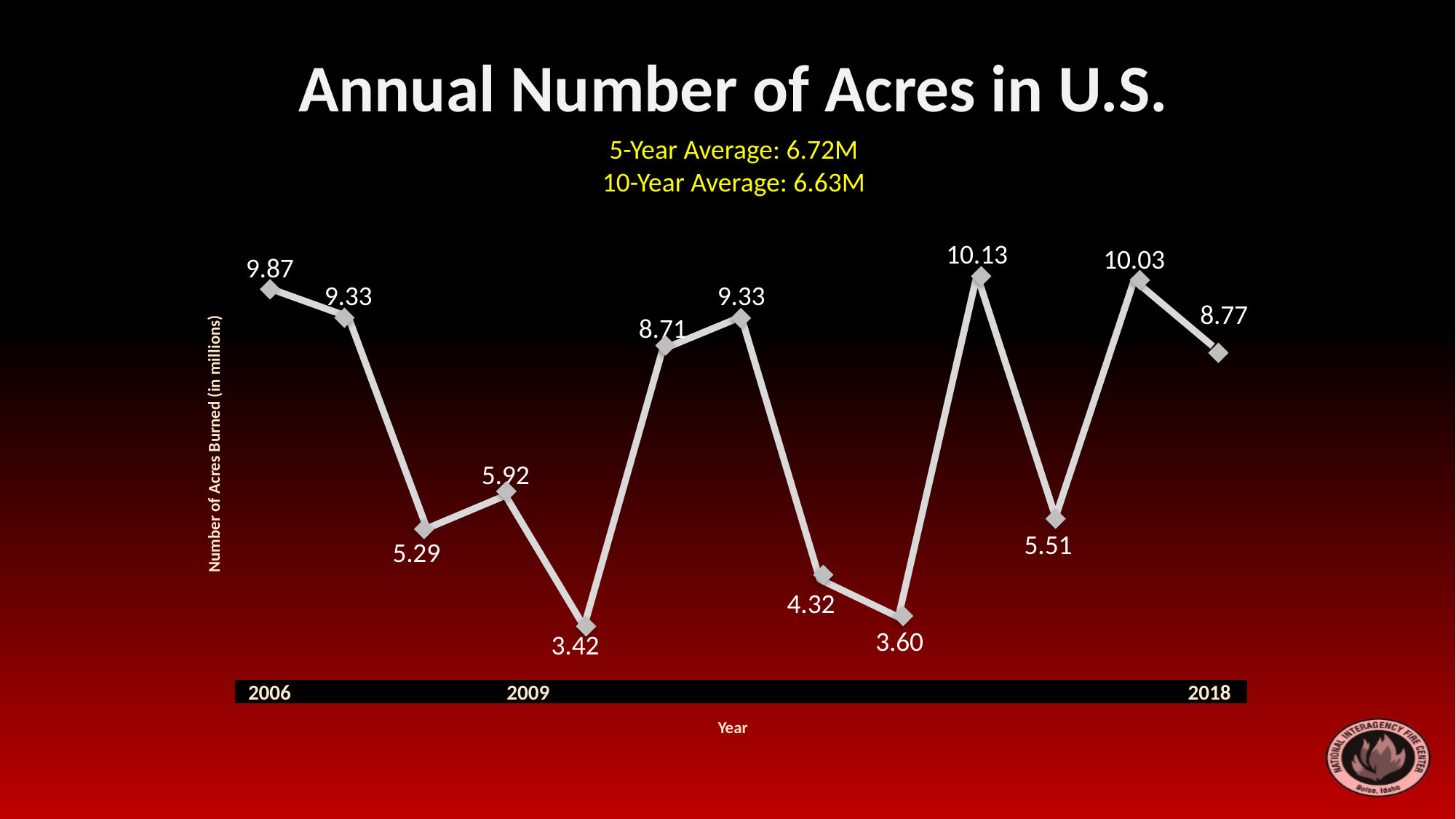
What is the number of acres burned (in millions) for 2009? 5.92 What is the 5-Year Average shown on the slide? 6.72M What is the number of acres burned (in millions) for 2006? 9.87 What is the highest value plotted on the chart? 10.13 What is the difference between the values for 2006 and 2018? 1.10 What type of chart is shown on the slide? line chart How many data points are plotted on the line? 13 What is the lowest value plotted on the chart? 3.42 Does the value rise or fall from 2006 to 2009? fall What is the title of the chart? Annual Number of Acres in U.S. Which year has the larger value, 2006 or 2009? 2006 What is the number of acres burned (in millions) for 2018? 8.77